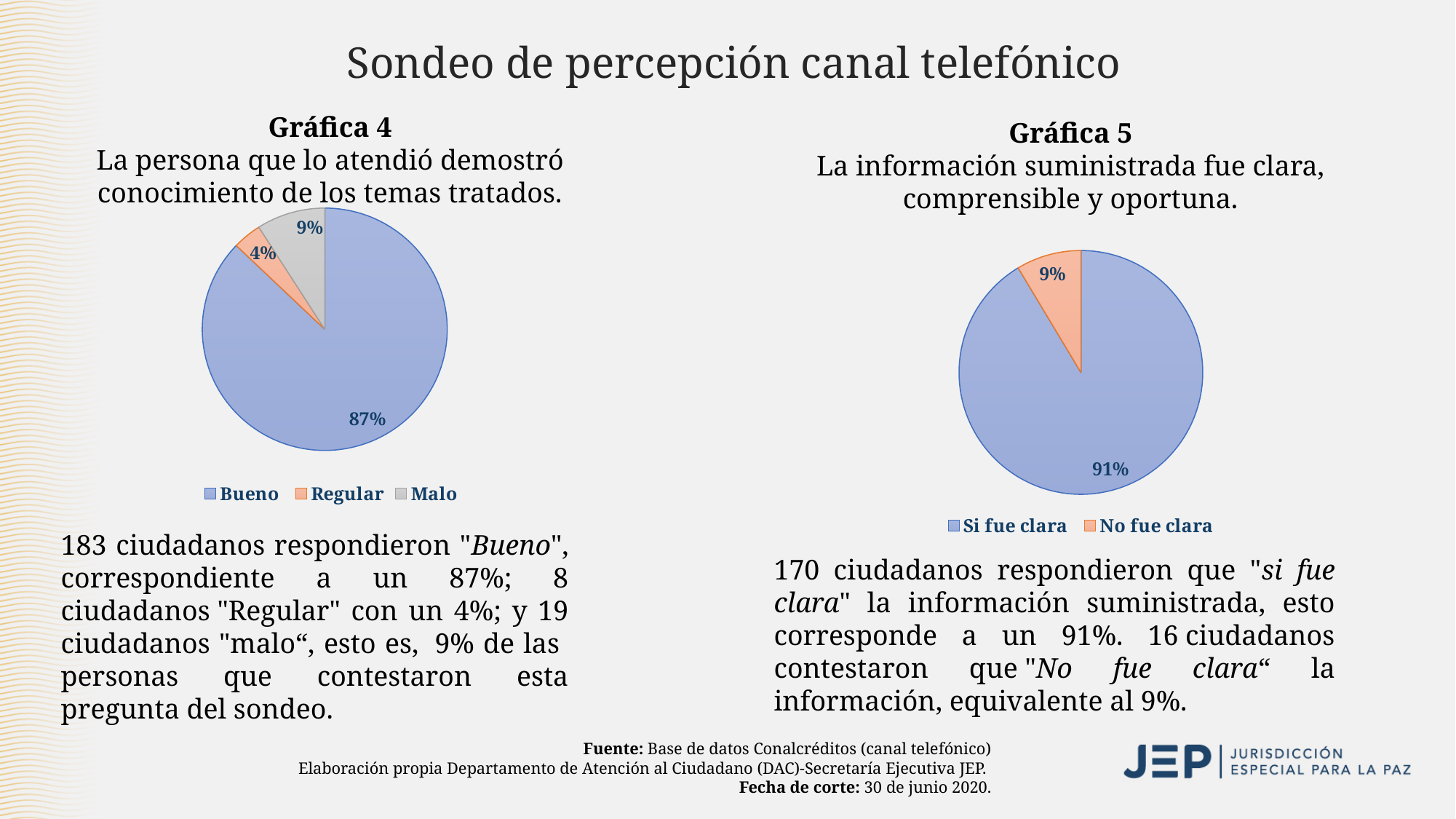
In Gráfica 4, what share of the pie is labelled "Bueno"? 87% In Gráfica 5, what share of the pie is labelled "Si fue clara"? 91% In Gráfica 4, which category has the largest slice? Bueno In Gráfica 4, what is the difference in percentage points between "Malo" and "Regular"? 5 In Gráfica 4, which category has the smallest slice? Regular In Gráfica 5, what percentage corresponds to "No fue clara"? 9% In Gráfica 4, how many categories does the legend list? 3 In Gráfica 5, which is larger, "Si fue clara" or "No fue clara"? Si fue clara What kind of chart is Gráfica 5? Pie chart In Gráfica 4, what percentage corresponds to "Regular"? 4% In Gráfica 4, what percentage corresponds to "Malo"? 9% In Gráfica 5, what colour is the "No fue clara" slice? Orange